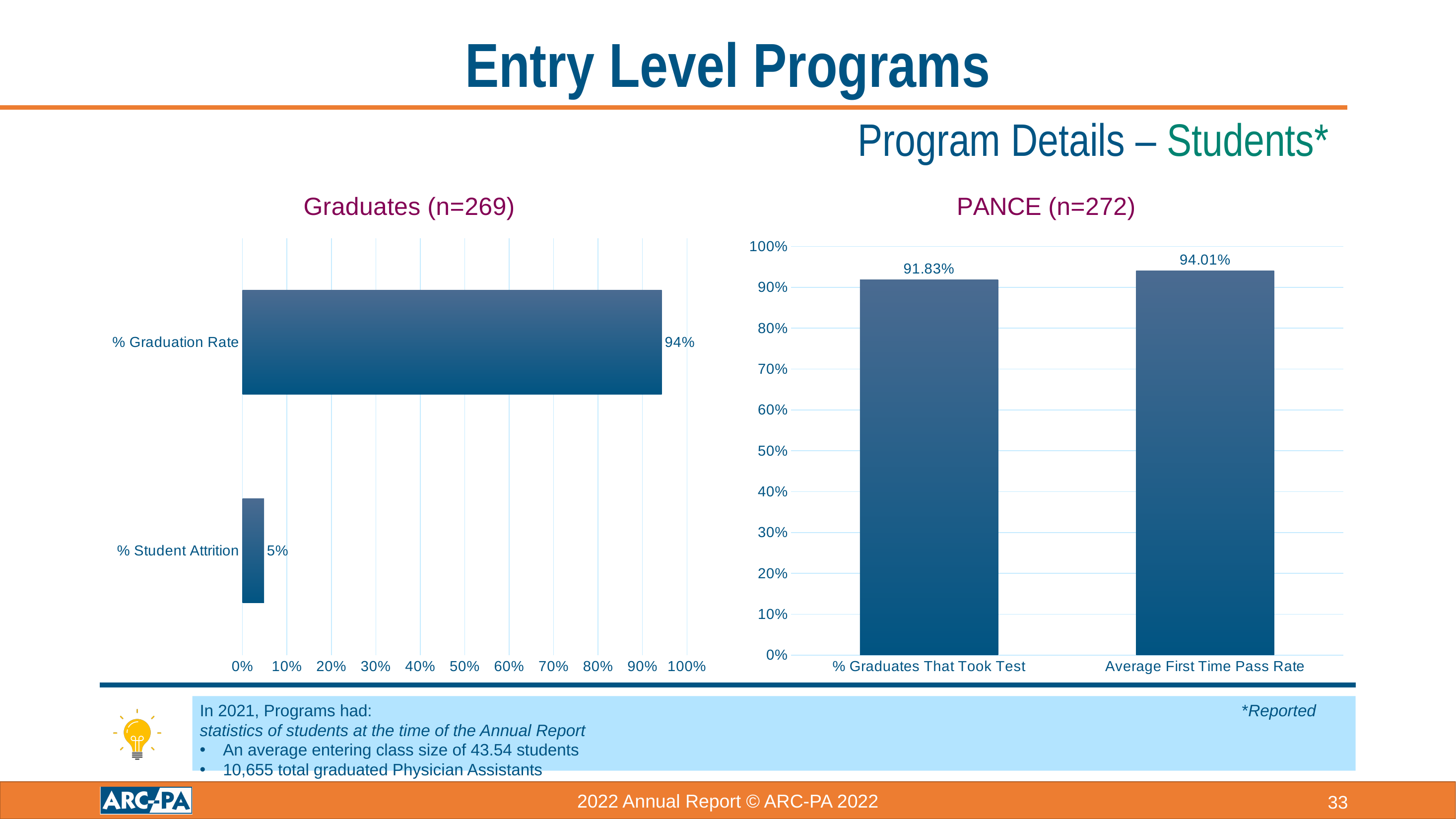
What is the title of the chart on the right side of the slide? PANCE (n=272) In the PANCE (n=272) chart, is the value for % Graduates That Took Test greater or less than 90%? greater In the Graduates (n=269) chart, which category has the highest value? % Graduation Rate In the PANCE (n=272) chart, which category has the lowest value? % Graduates That Took Test What kind of chart is the Graduates (n=269) chart? Bar chart In the Graduates (n=269) chart, how many categories are plotted? 2 In the Graduates (n=269) chart, what is the value for % Graduation Rate? 94% In the Graduates (n=269) chart, what is the value for % Student Attrition? 5% In the Graduates (n=269) chart, what is the difference between % Graduation Rate and % Student Attrition? 89% In the PANCE (n=272) chart, what is the value for % Graduates That Took Test? 91.83% In the PANCE (n=272) chart, what is the value for Average First Time Pass Rate? 94.01% In the PANCE (n=272) chart, what is the difference between Average First Time Pass Rate and % Graduates That Took Test? 2.18%